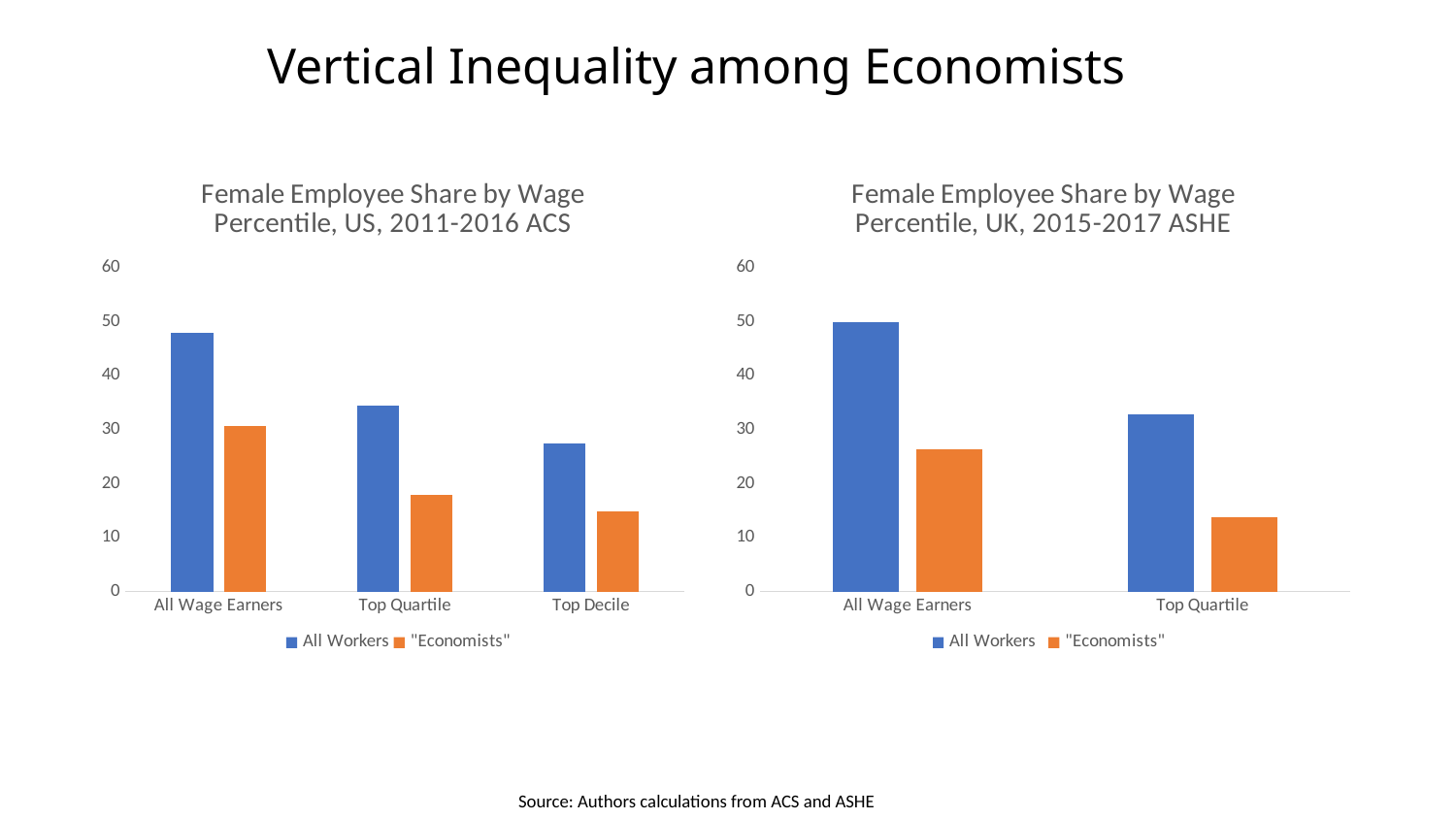
In the US chart, is the 'All Workers' value for All Wage Earners greater or less than 40? greater In the US chart, do the 'All Workers' values rise or fall from All Wage Earners to Top Decile? fall How many series does the legend of the US chart list? 2 In the US chart, how many wage percentile categories are shown on the x axis? 3 In the UK chart, how many categories are shown on the x axis? 2 In the UK chart, which is larger for Top Quartile: 'All Workers' or '"Economists"'? All Workers What kind of chart is the left chart, 'Female Employee Share by Wage Percentile, US, 2011-2016 ACS'? bar chart In the US chart, which category has the highest 'All Workers' value? All Wage Earners In the US chart, is the '"Economists"' value for Top Decile greater or less than 20? less In the UK chart, which colour represents the '"Economists"' series? orange In the UK chart, is the '"Economists"' value for Top Quartile greater or less than 20? less In the US chart, which category has the lowest '"Economists"' value? Top Decile